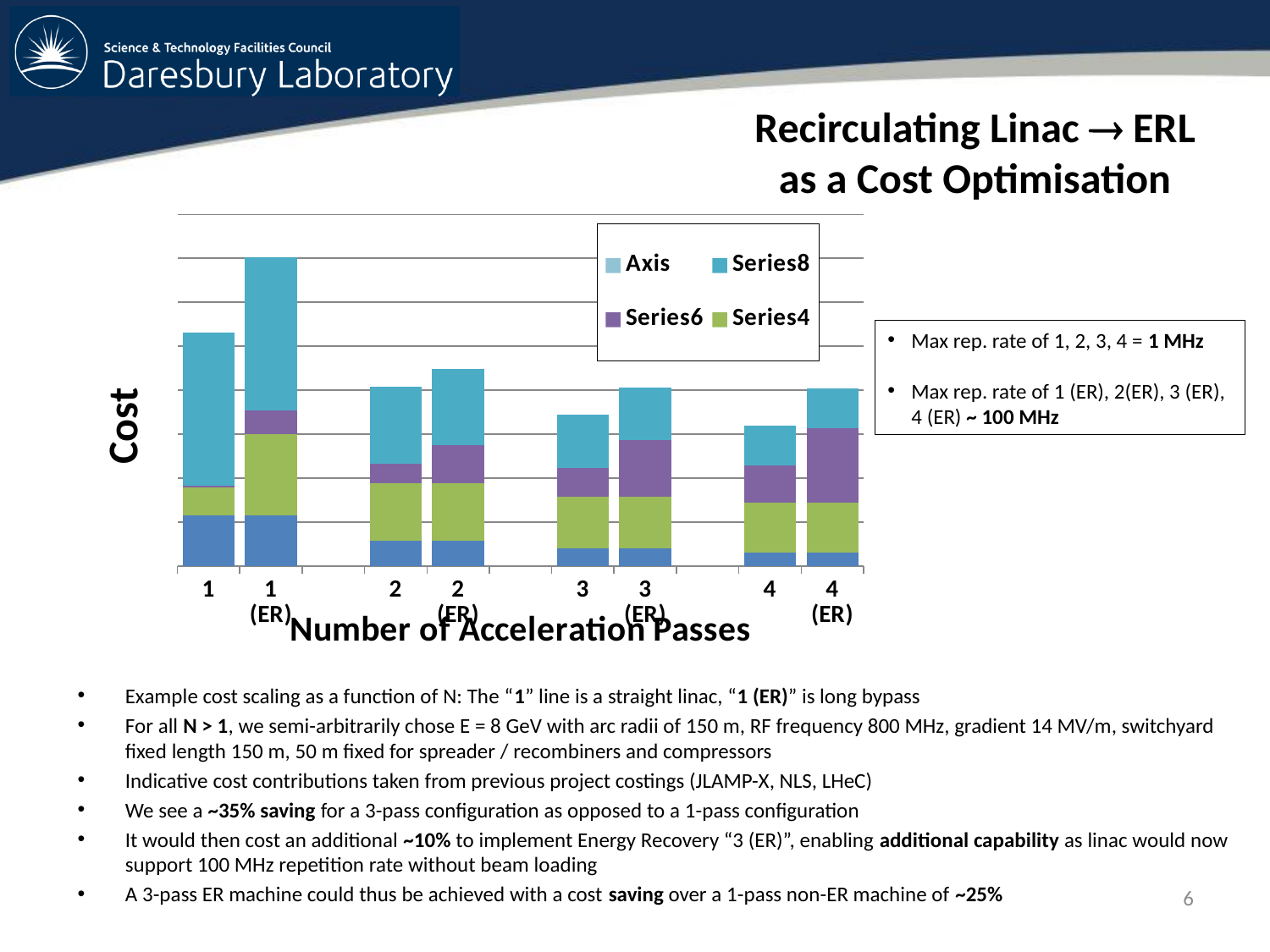
What kind of chart is shown on the slide? Stacked bar chart What is the title of the y axis of the chart? Cost Which stacked bar is taller, the one for 2 or the one for 2 (ER)? 2 (ER) Which stacked bar is taller, the one for 1 or the one for 1 (ER)? 1 (ER) Which stacked bar is taller, the one for 3 or the one for 4? 3 Which category has the tallest stacked bar in the chart? 1 (ER) What is the title of the x axis of the chart? Number of Acceleration Passes How many series does the chart legend list? 4 How many categories are shown along the x axis of the chart? 8 Which category has the shortest stacked bar in the chart? 4 Do the total bar heights for the non-ER categories (1, 2, 3, 4) rise or fall as the number of acceleration passes increases? Fall